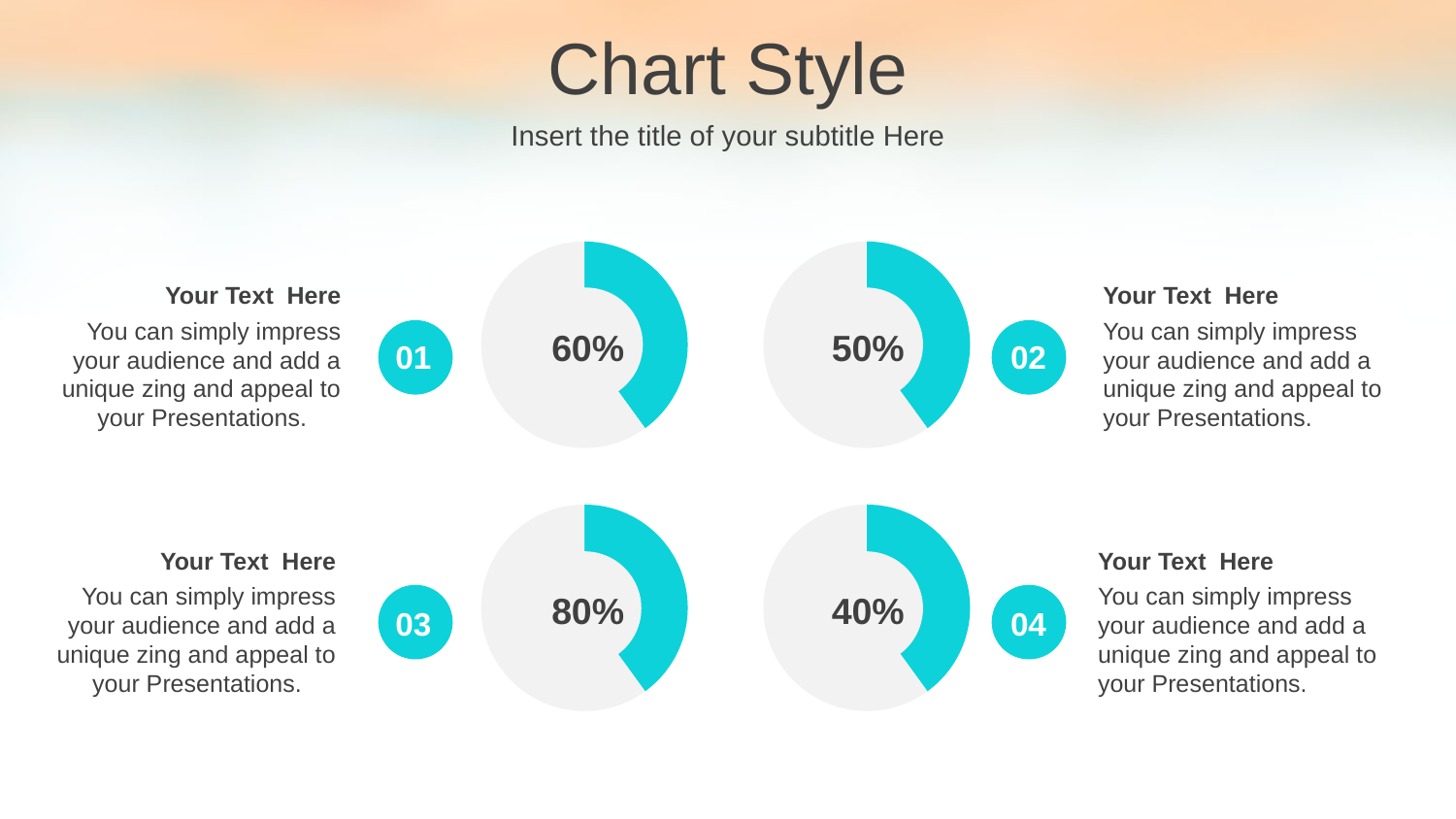
What percentage is shown in the donut chart next to label 03 (bottom left)? 80% What is the difference between the percentage in chart 03 and the percentage in chart 04? 40% How many donut charts are on the slide? 4 What is the title of the slide containing the four donut charts? Chart Style Which of the four donut charts shows the lowest percentage? 04 (40%) What percentage is shown in the donut chart next to label 01 (top left)? 60% What kind of chart is used for each of the four figures on the slide? Donut chart Which of the four donut charts shows the highest percentage? 03 (80%) Which shows a larger percentage, chart 01 or chart 02? Chart 01 What percentage is shown in the donut chart next to label 04 (bottom right)? 40% What percentage is shown in the donut chart next to label 02 (top right)? 50% What is the difference between the percentage in chart 01 and the percentage in chart 02? 10%